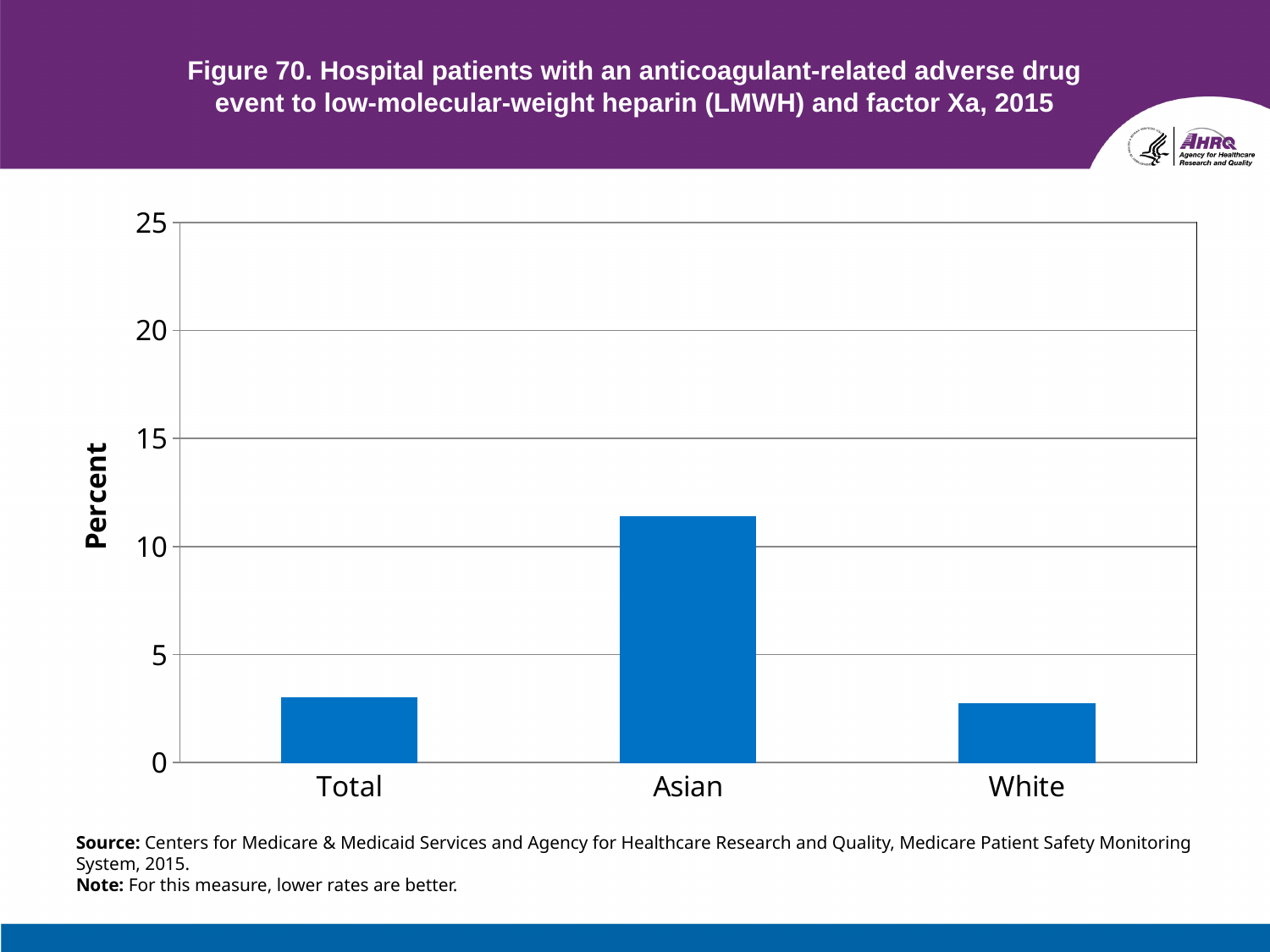
What is the label on the y axis of the chart? Percent Is the value for Asian greater or less than 10? greater Is the value for Asian greater or less than 15? less How many categories are shown on the x axis of the chart? 3 Is the value for White greater or less than 5? less Which is larger, the value for Total or the value for Asian? Asian Which is larger, the value for Asian or the value for White? Asian Which category has the highest value in the chart? Asian What kind of chart is shown on the slide? bar chart What is the highest value shown on the y axis of the chart? 25